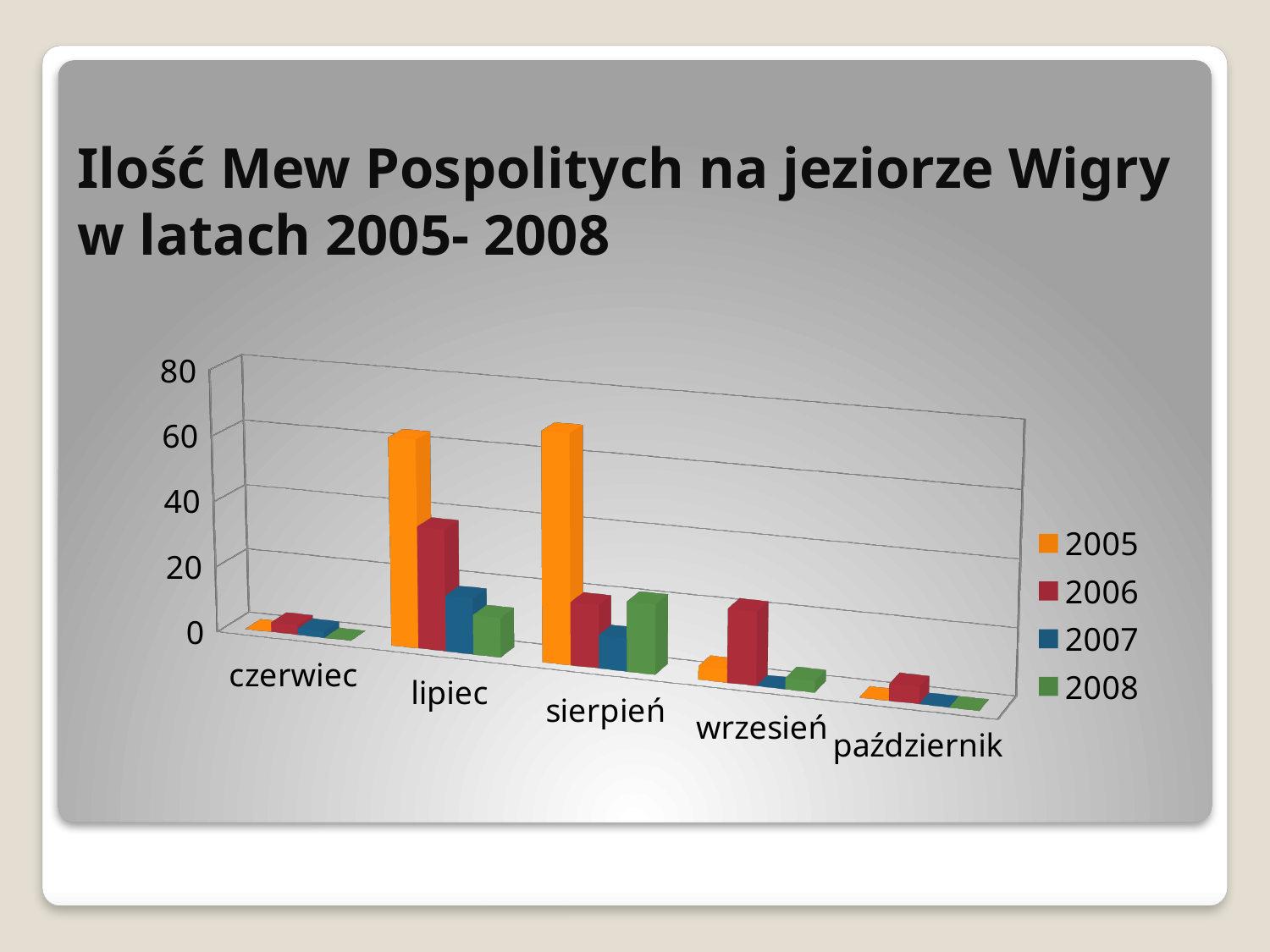
Which years are listed in the legend? 2005, 2006, 2007, 2008 Is the value for 2006 in lipiec greater or less than 20? greater Is the value for 2006 in lipiec greater or less than 40? less Is the value for 2005 in lipiec greater or less than 40? greater In wrzesień, which is larger: the value for 2005 or the value for 2006? 2006 Which colour represents the 2005 series in the legend? orange How many months (categories) are shown on the x axis? 5 How many series does the legend list? 4 Which series has the highest value in lipiec? 2005 What kind of chart is shown on the slide? bar chart